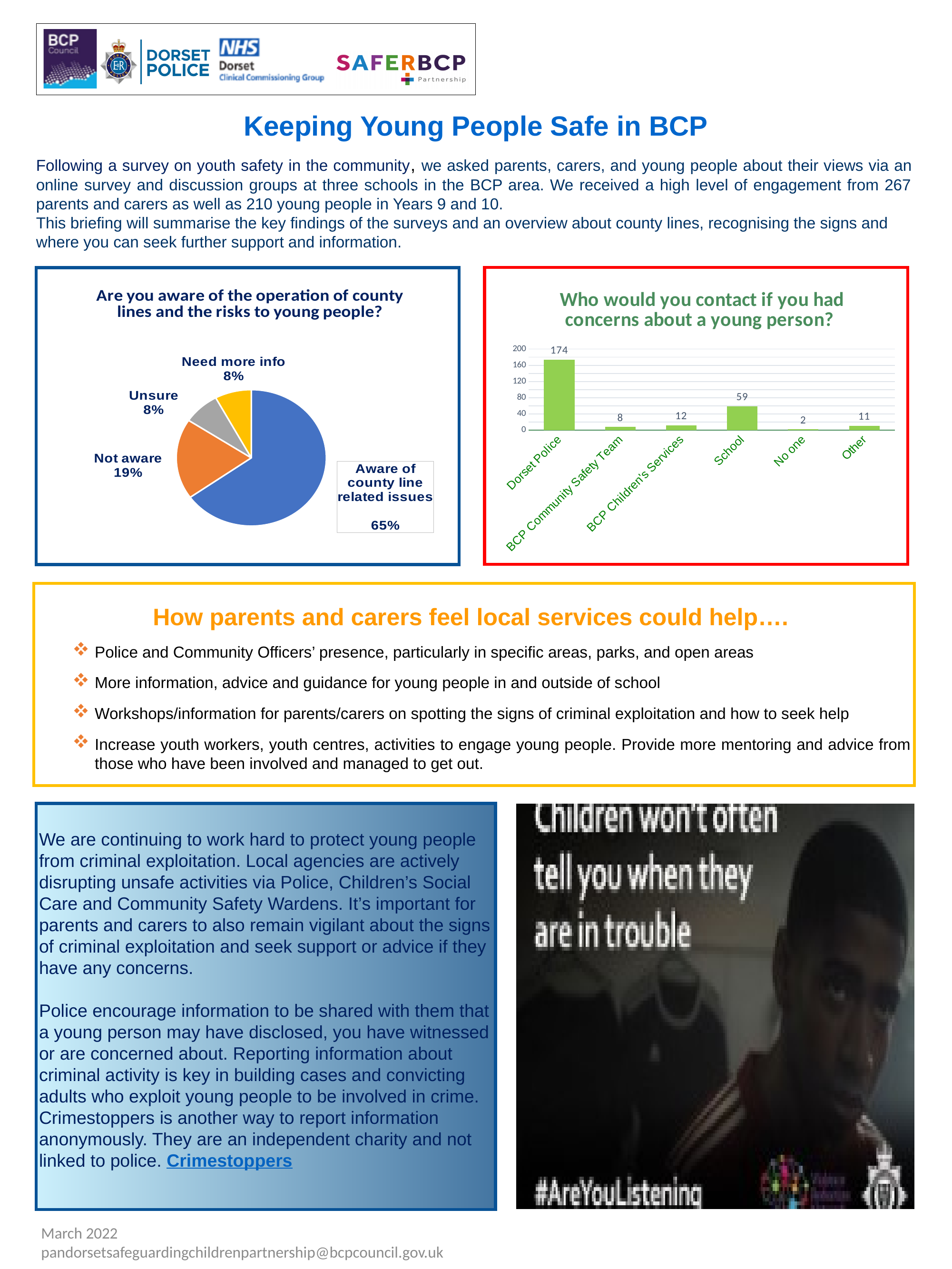
In the pie chart 'Are you aware of the operation of county lines and the risks to young people?', what share is 'Aware of county line related issues'? 65% In the pie chart 'Are you aware of the operation of county lines and the risks to young people?', which category has the largest share? Aware of county line related issues In the bar chart 'Who would you contact if you had concerns about a young person?', what is the difference between Dorset Police and School? 115 In the bar chart 'Who would you contact if you had concerns about a young person?', what is the value for School? 59 In the pie chart 'Are you aware of the operation of county lines and the risks to young people?', what is the difference between the 'Not aware' share and the 'Unsure' share? 11% In the bar chart 'Who would you contact if you had concerns about a young person?', what is the value for Dorset Police? 174 In the bar chart 'Who would you contact if you had concerns about a young person?', which is larger: BCP Children's Services or BCP Community Safety Team? BCP Children's Services In the bar chart 'Who would you contact if you had concerns about a young person?', which category has the lowest value? No one What type of chart is 'Who would you contact if you had concerns about a young person?'? Bar chart In the pie chart 'Are you aware of the operation of county lines and the risks to young people?', what share is 'Not aware'? 19% In the bar chart 'Who would you contact if you had concerns about a young person?', how many categories are shown? 6 In the pie chart 'Are you aware of the operation of county lines and the risks to young people?', how many slices are there? 4